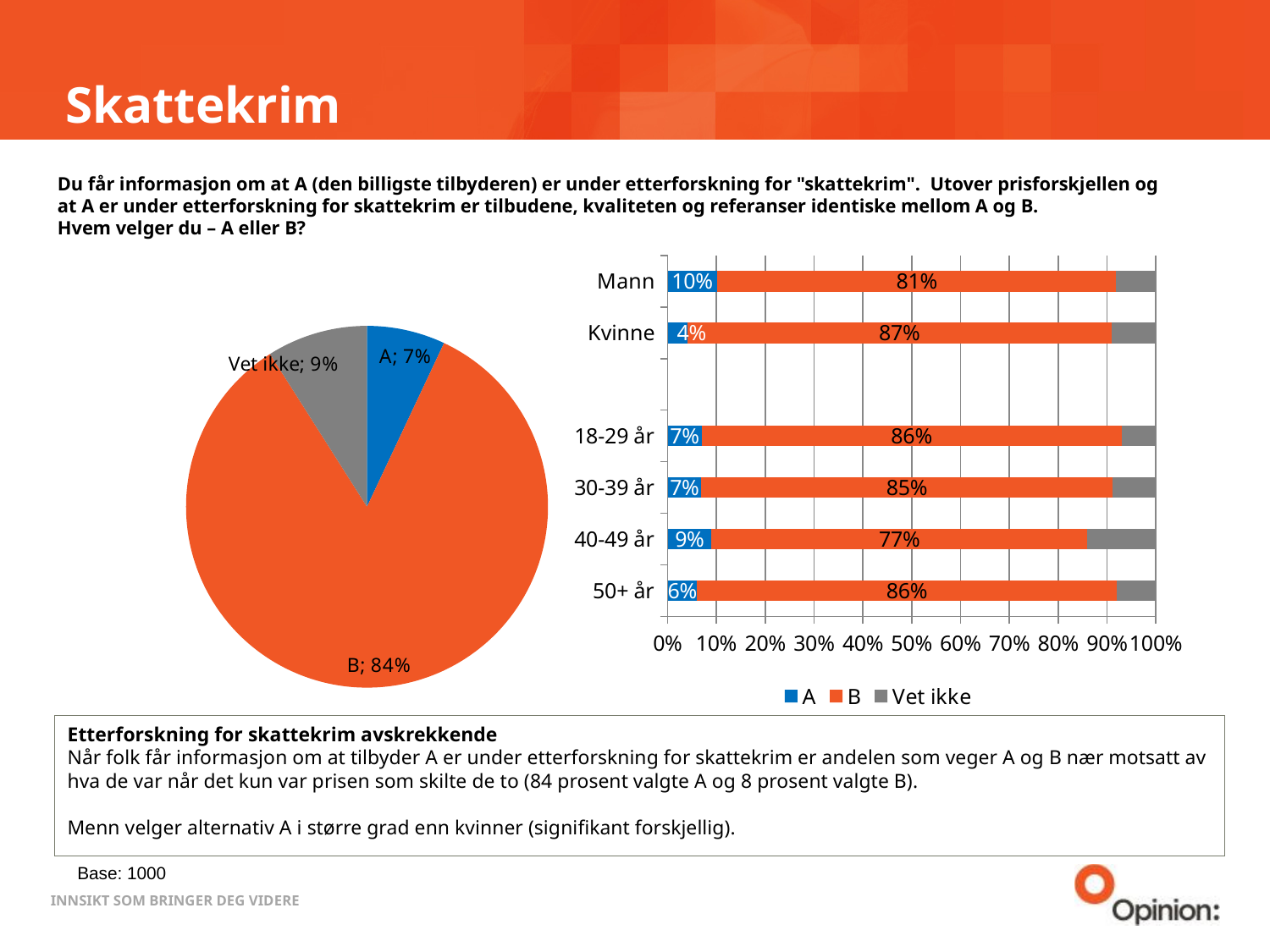
In the bar chart on the right, what is the value of B for Kvinne? 87% In the pie chart on the left, what share is labelled for Vet ikke? 9% In the pie chart on the left, what share is labelled for A? 7% In the pie chart on the left, how many slices are there? 3 In the bar chart on the right, which category has the highest value for A? Mann In the pie chart on the left, which slice is the largest? B In the pie chart on the left, what share is labelled for B? 84% In the bar chart on the right, which category has the lowest value for B? 40-49 år How many series does the legend of the bar chart on the right list? 3 In the bar chart on the right, what is the difference between the A values for Mann and Kvinne? 6% In the bar chart on the right, what is the value of B for 40-49 år? 77% In the bar chart on the right, what is the value of A for Mann? 10%